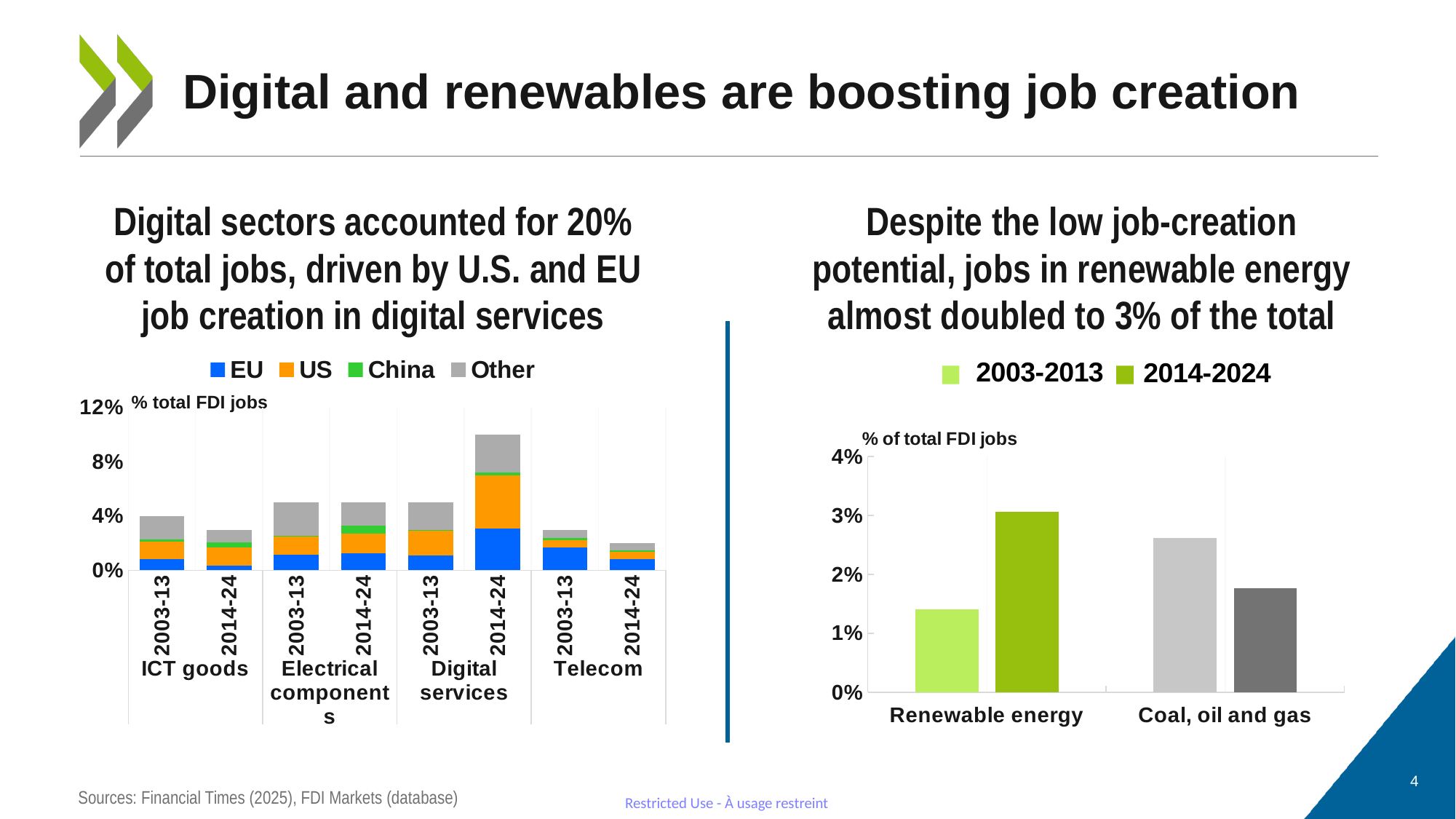
In the right chart, how many series does the legend list? 2 In the right chart, is the value for Coal, oil and gas in 2014-2024 greater or less than 2%? less In the left chart, which colour represents the US series? orange In the left chart, which bar is the tallest overall? Digital services 2014-24 In the right chart, which bar is the highest? Renewable energy 2014-2024 In the left chart, is the total for Digital services 2014-24 greater or less than 8%? greater What kind of chart is the left chart titled 'Digital sectors accounted for 20% of total jobs...'? stacked bar chart In the right chart, which bar is the lowest? Renewable energy 2003-2013 In the left chart, is the total for Telecom 2014-24 greater or less than 4%? less In the left chart, how many sectors are shown on the x axis? 4 How many series does the legend of the left chart list? 4 In the right chart, which is larger for Coal, oil and gas: 2003-2013 or 2014-2024? 2003-2013